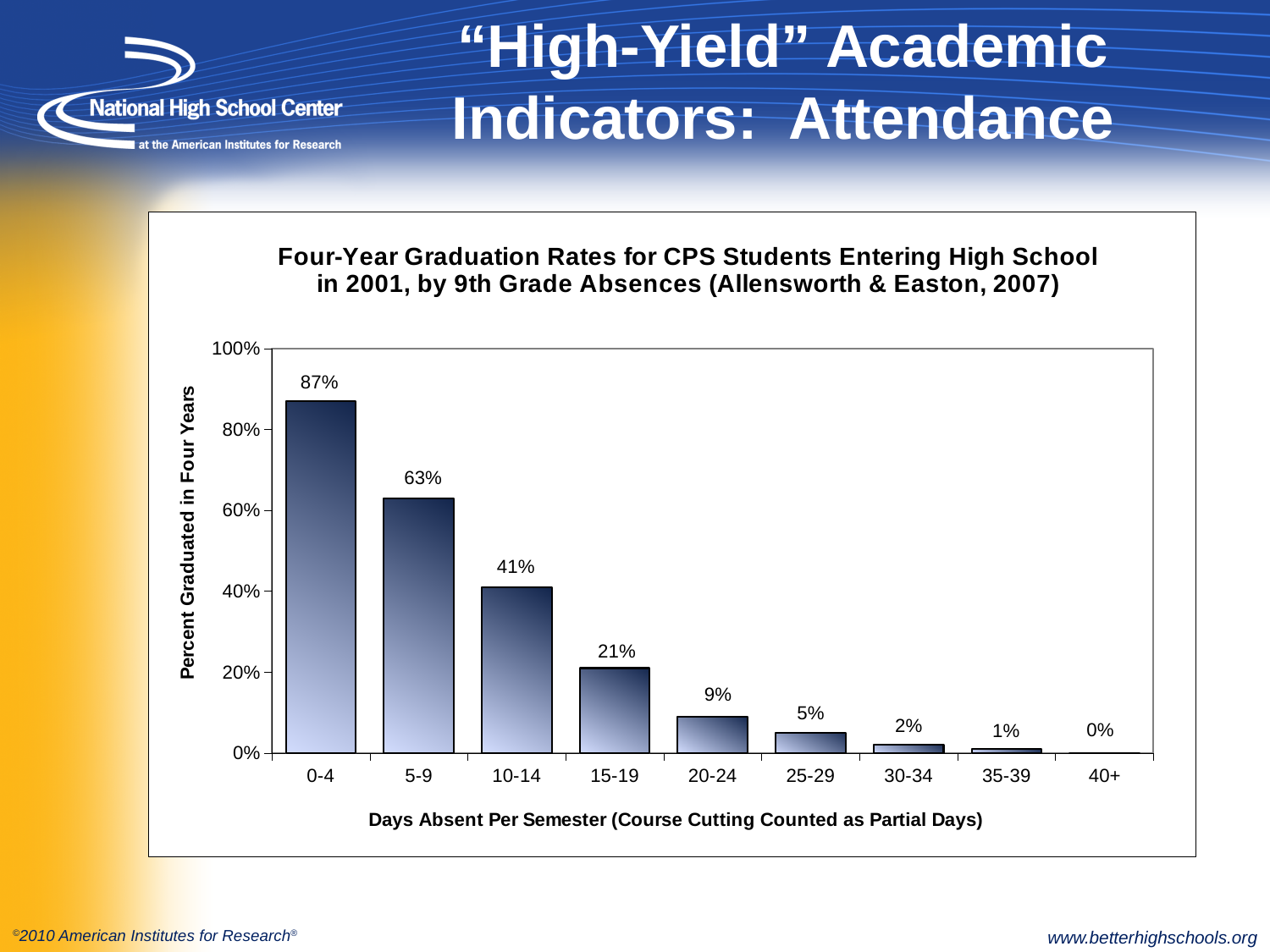
What is the graduation rate for students absent 10-14 days per semester? 41% What kind of chart is shown on the slide? Bar chart What is the difference in graduation rate between the 0-4 and 5-9 absence categories? 24% What is the label of the y axis? Percent Graduated in Four Years How many absence categories are shown on the x axis? 9 What is the graduation rate for the 25-29 days absent category? 5% Do graduation rates rise or fall as days absent per semester increase? Fall Which has a higher graduation rate, the 10-14 category or the 15-19 category? 10-14 What is the four-year graduation rate for students with 0-4 days absent per semester? 87% Which absence category has the lowest graduation rate? 40+ Which absence category has the highest graduation rate? 0-4 What is the difference in graduation rate between the 15-19 and 20-24 absence categories? 12%